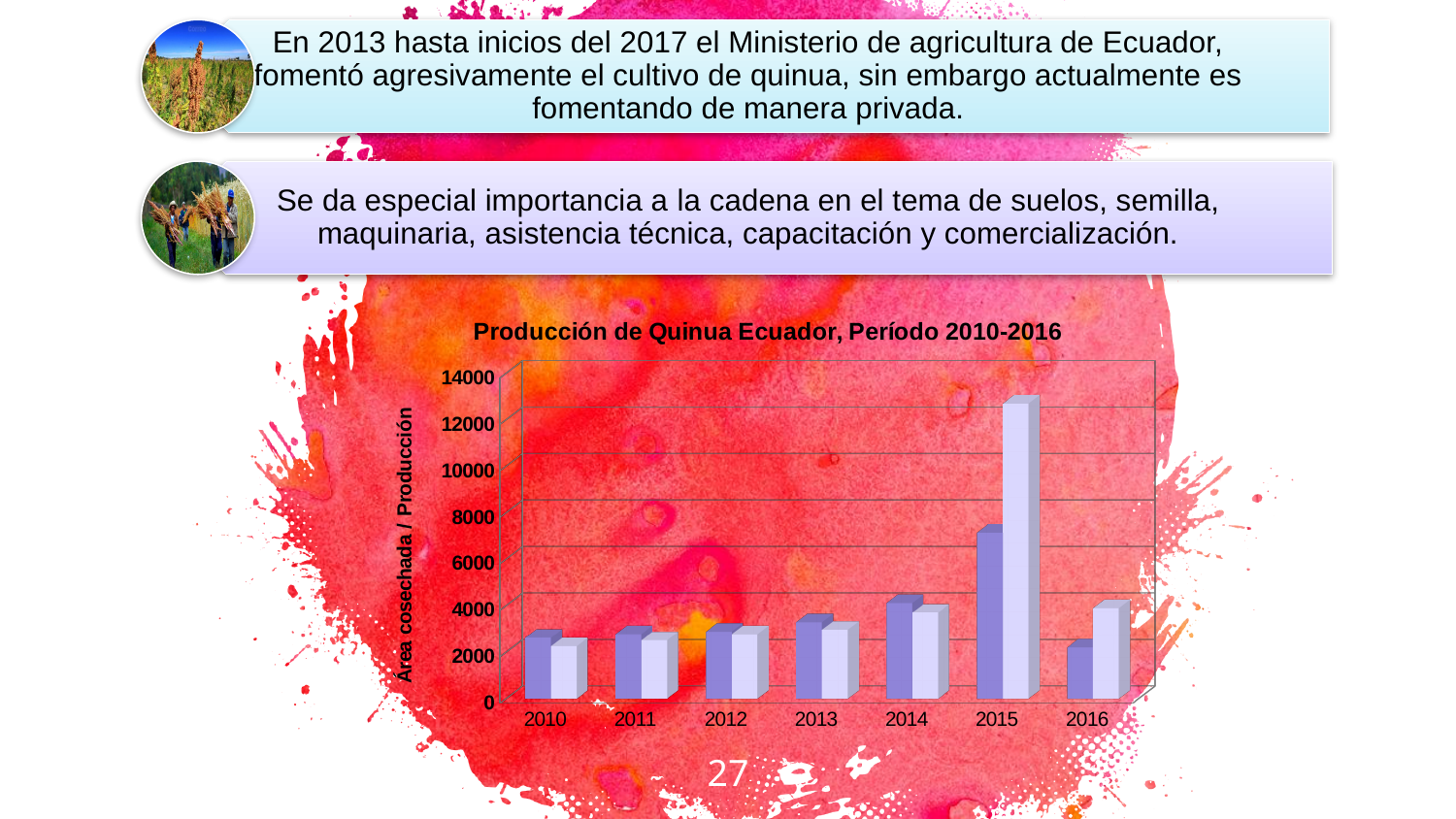
In which year is the darker purple bar the highest? 2015 How many years (categories) are shown on the x axis of the chart? 7 Is the darker purple bar for 2016 greater or less than 4000? less Is the lighter bar for 2010 greater or less than 4000? less For 2016, which bar is larger, the darker purple bar or the lighter bar? the lighter bar Is the lighter bar for 2015 greater or less than 12000? greater What is the title of the chart? Producción de Quinua Ecuador, Período 2010-2016 What type of chart is shown on the slide? bar chart In which year is the lighter-coloured bar the highest? 2015 What is the label on the vertical axis of the chart? Área cosechada / Producción For 2015, which bar is larger, the darker purple bar or the lighter bar? the lighter bar